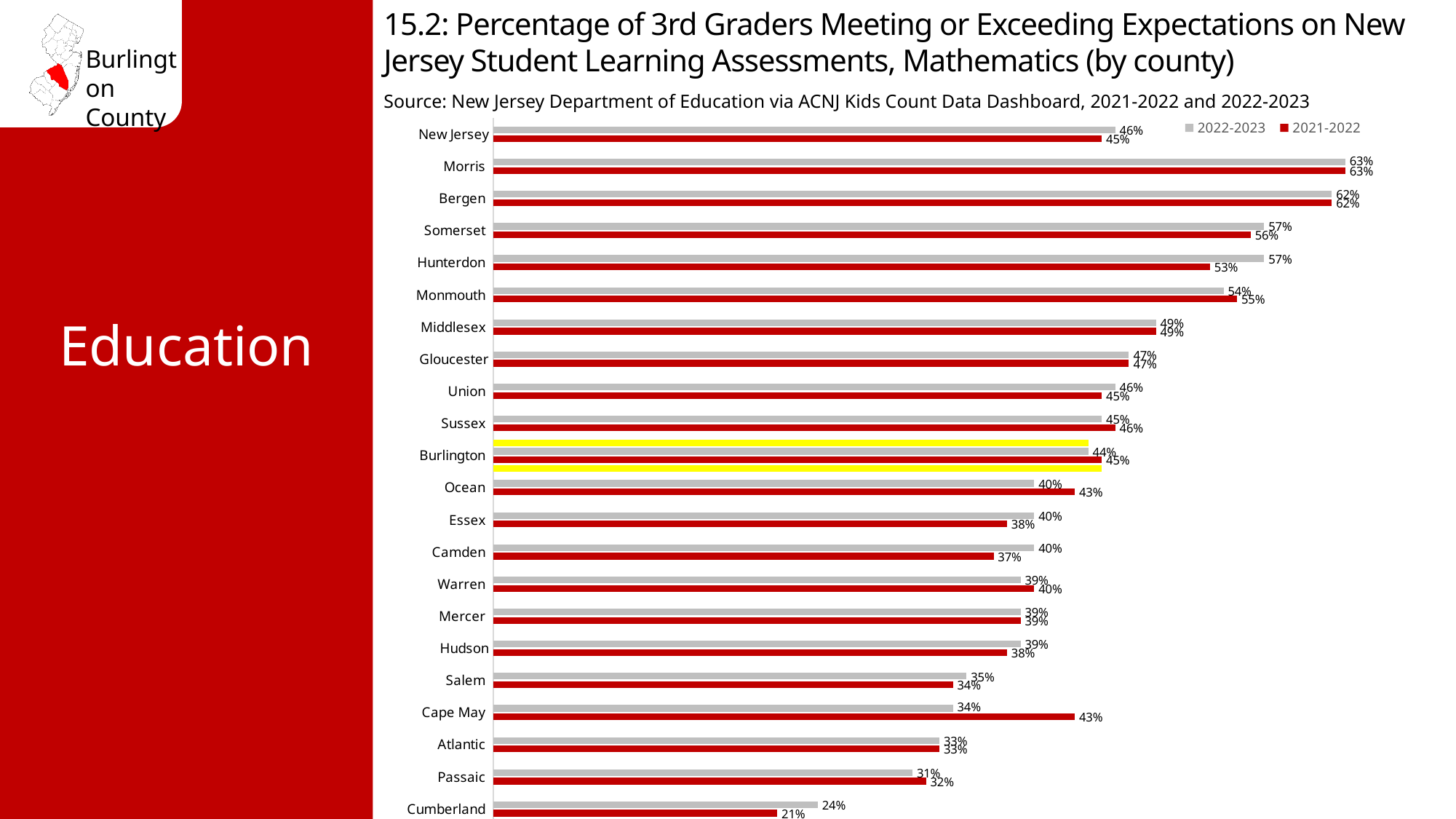
What was the 2021-2022 value for Cape May? 43% What was the 2022-2023 value for Burlington? 44% Which is larger for Hunterdon: the 2022-2023 value or the 2021-2022 value? 2022-2023 Which county had the lowest 2021-2022 value? Cumberland What is the difference between the 2021-2022 and 2022-2023 values for Cape May? 9% What was the 2022-2023 value for Hunterdon? 57% What kind of chart is shown on the slide? Bar chart How many series does the legend list? 2 How many categories (including New Jersey) are shown on the chart? 22 Which colour represents the 2021-2022 series? Red What is the difference between the 2022-2023 and 2021-2022 values for Cumberland? 3% Which county had the highest 2022-2023 value? Morris